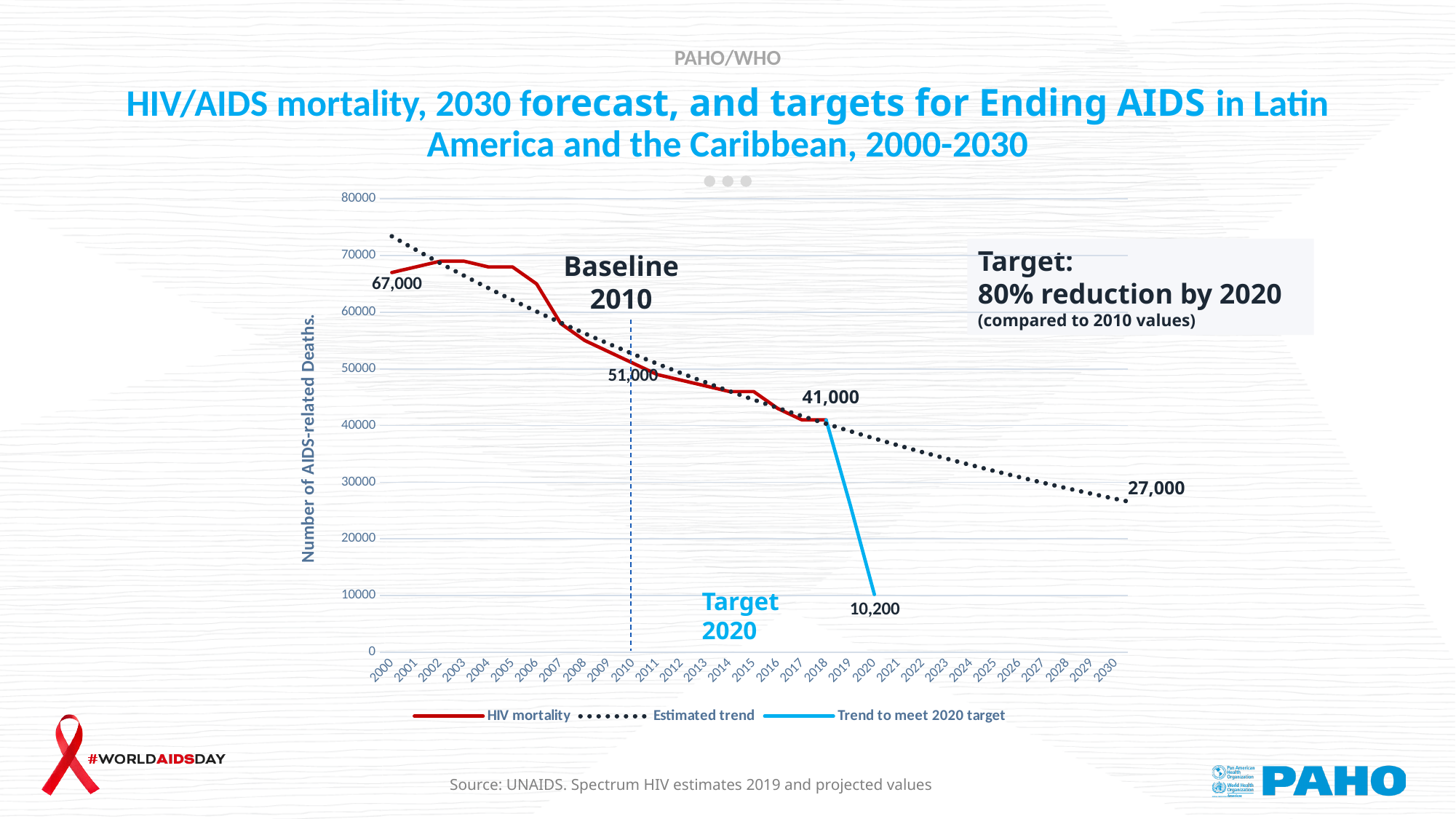
How many series does the legend list? 3 What was the number of AIDS-related deaths in 2000 according to the HIV mortality line? 67,000 What is the baseline 2010 value for AIDS-related deaths? 51,000 What is the difference between the 2010 baseline value and the 2018 value? 10,000 By how much did HIV mortality fall between 2000 (67,000) and the 2010 baseline (51,000)? 16,000 What is the 2020 target value for AIDS-related deaths? 10,200 Which series in the legend is drawn as a solid blue line? Trend to meet 2020 target Is the HIV mortality value for 2005 greater or less than 60000? greater Does the HIV mortality line rise or fall overall from 2000 to 2018? fall What kind of chart is shown on the slide? line chart What value does the estimated trend reach in 2030? 27,000 What is the HIV mortality value labelled for 2018? 41,000